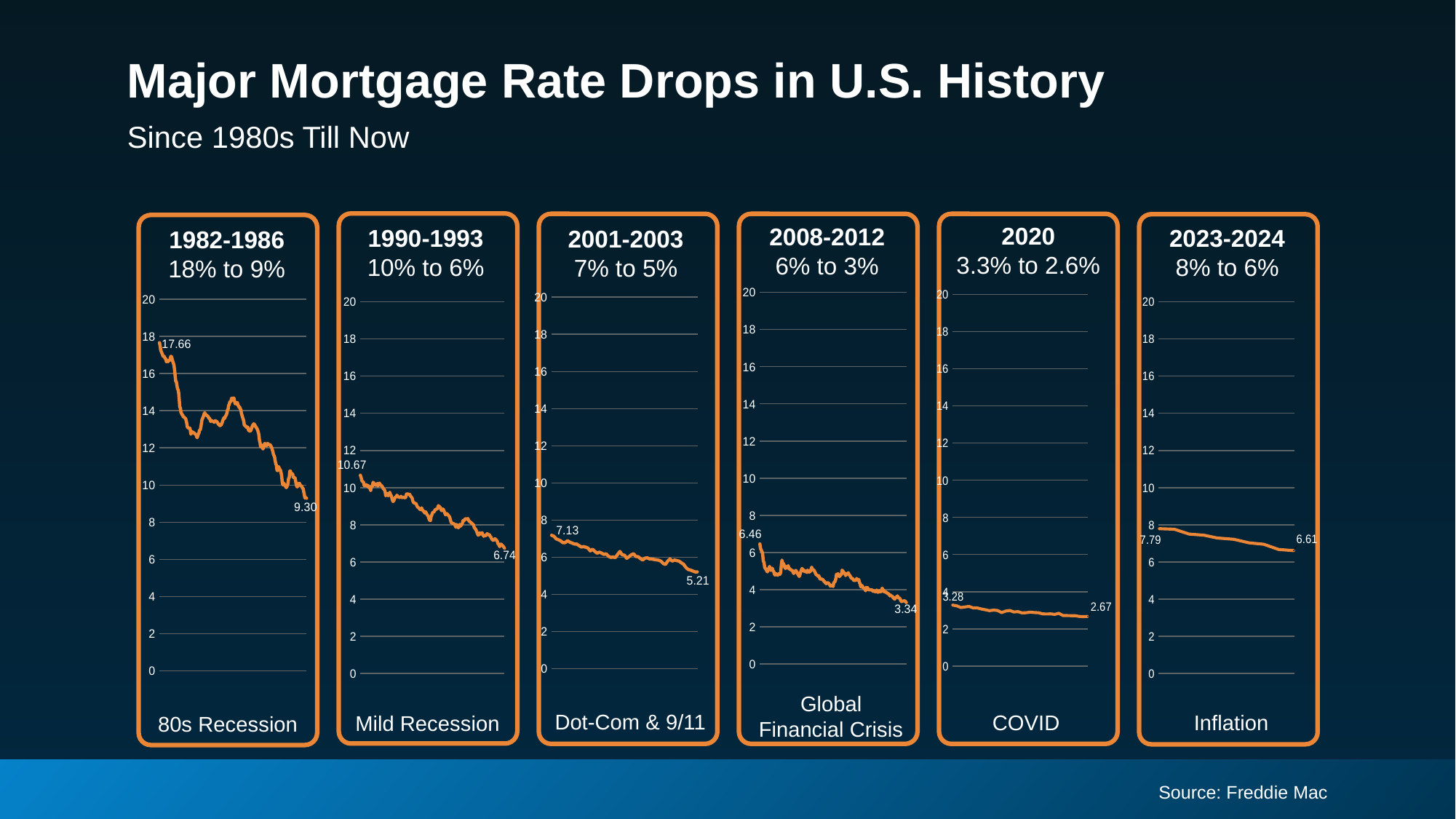
What kind of chart is used in each of the six panels on the slide? Line chart In the Mild Recession chart, do the values rise or fall from left to right? Fall In the Mild Recession chart, what is the ending value labelled on the line? 6.74 In the 80s Recession chart, what is the starting value labelled on the line? 17.66 Which chart has the highest labelled starting value: 80s Recession or Mild Recession? 80s Recession In the 80s Recession chart, what is the ending value labelled on the line? 9.30 In the COVID chart, what is the difference between the starting value and the ending value? 0.61 In the Global Financial Crisis chart, what is the ending value labelled on the line? 3.34 In the 80s Recession chart, how much did the rate fall from its labelled start to its labelled end? 8.36 In the Inflation chart, what is the difference between the starting value 7.79 and the ending value 6.61? 1.18 In the Dot-Com & 9/11 chart, what is the starting value labelled on the line? 7.13 How many charts are shown on the slide? 6